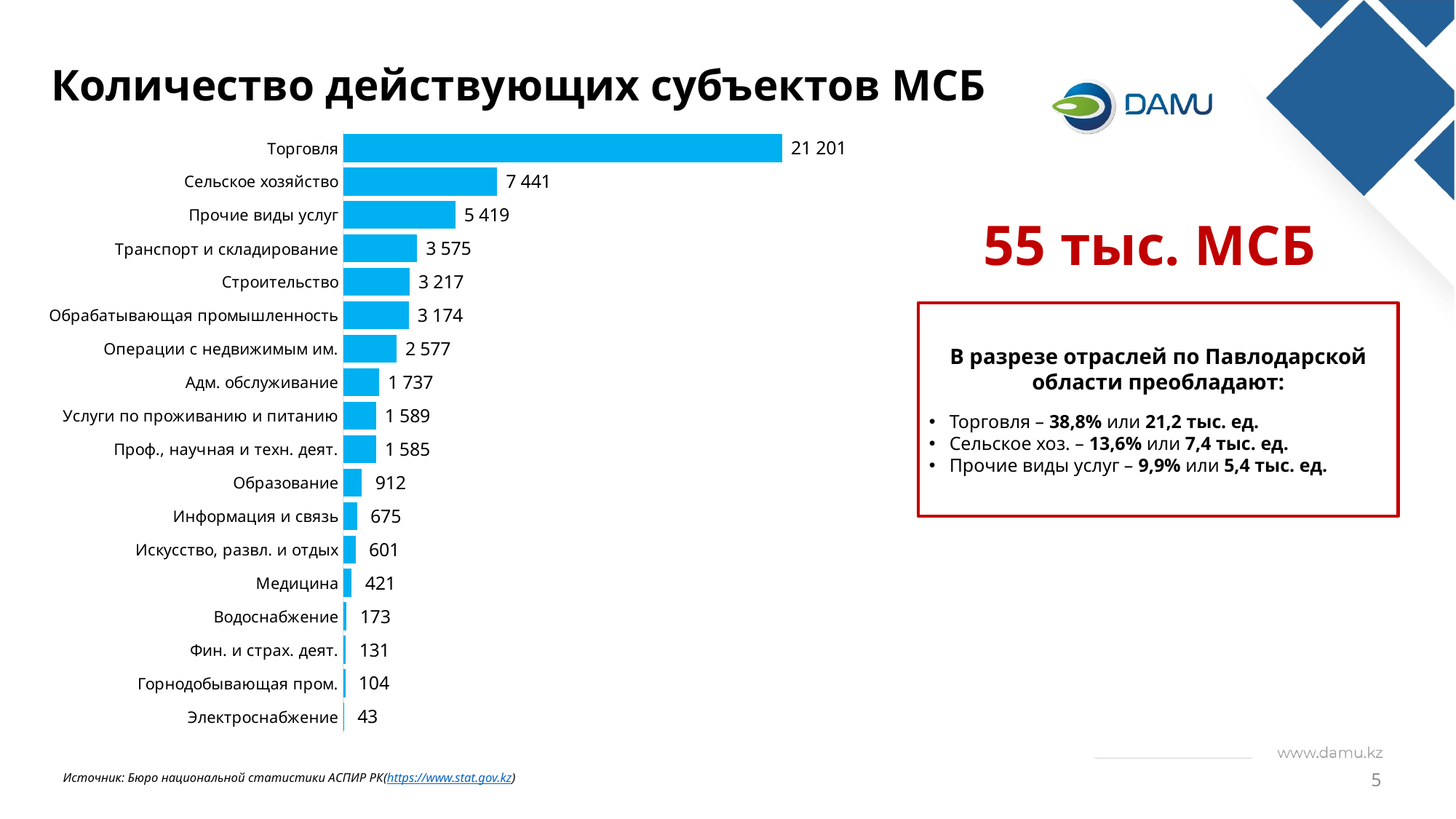
What is the value for Сельское хозяйство? 7 441 What is the value for Торговля? 21 201 What is the difference between the values for Образование and Информация и связь? 237 What type of chart is shown on the slide? Bar chart Which category has the lowest value? Электроснабжение Which is larger, the value for Транспорт и складирование or the value for Строительство? Транспорт и складирование Which category has the highest value? Торговля What is the title of the slide containing the chart? Количество действующих субъектов МСБ What is the value for Обрабатывающая промышленность? 3 174 How many categories are shown in the chart? 18 What is the difference between the values for Торговля and Сельское хозяйство? 13 760 What is the value for Медицина? 421